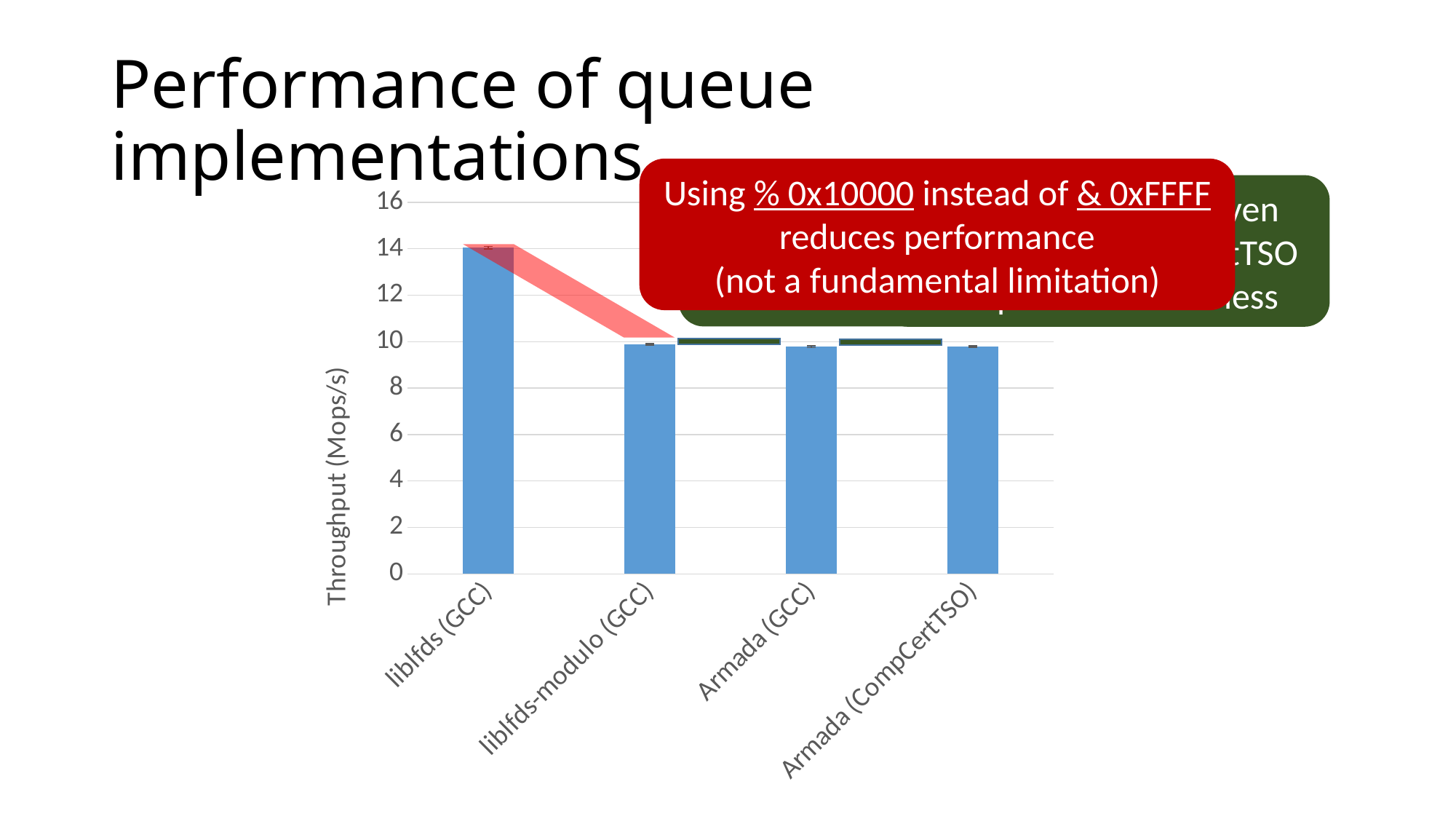
Does the throughput rise or fall from liblfds (GCC) to liblfds-modulo (GCC)? fall How many queue implementations (categories) are plotted on the x axis? 4 Is the throughput for liblfds-modulo (GCC) greater or less than 14 Mops/s? less What is the label of the y axis? Throughput (Mops/s) Which has the higher throughput, liblfds (GCC) or Armada (GCC)? liblfds (GCC) What kind of chart is shown on the slide? bar chart Is the throughput for Armada (CompCertTSO) greater or less than 8 Mops/s? greater Is the throughput for liblfds (GCC) greater or less than 12 Mops/s? greater Which has the higher throughput, liblfds (GCC) or Armada (CompCertTSO)? liblfds (GCC) Which implementation has the highest throughput? liblfds (GCC) What is the highest tick value shown on the y axis? 16